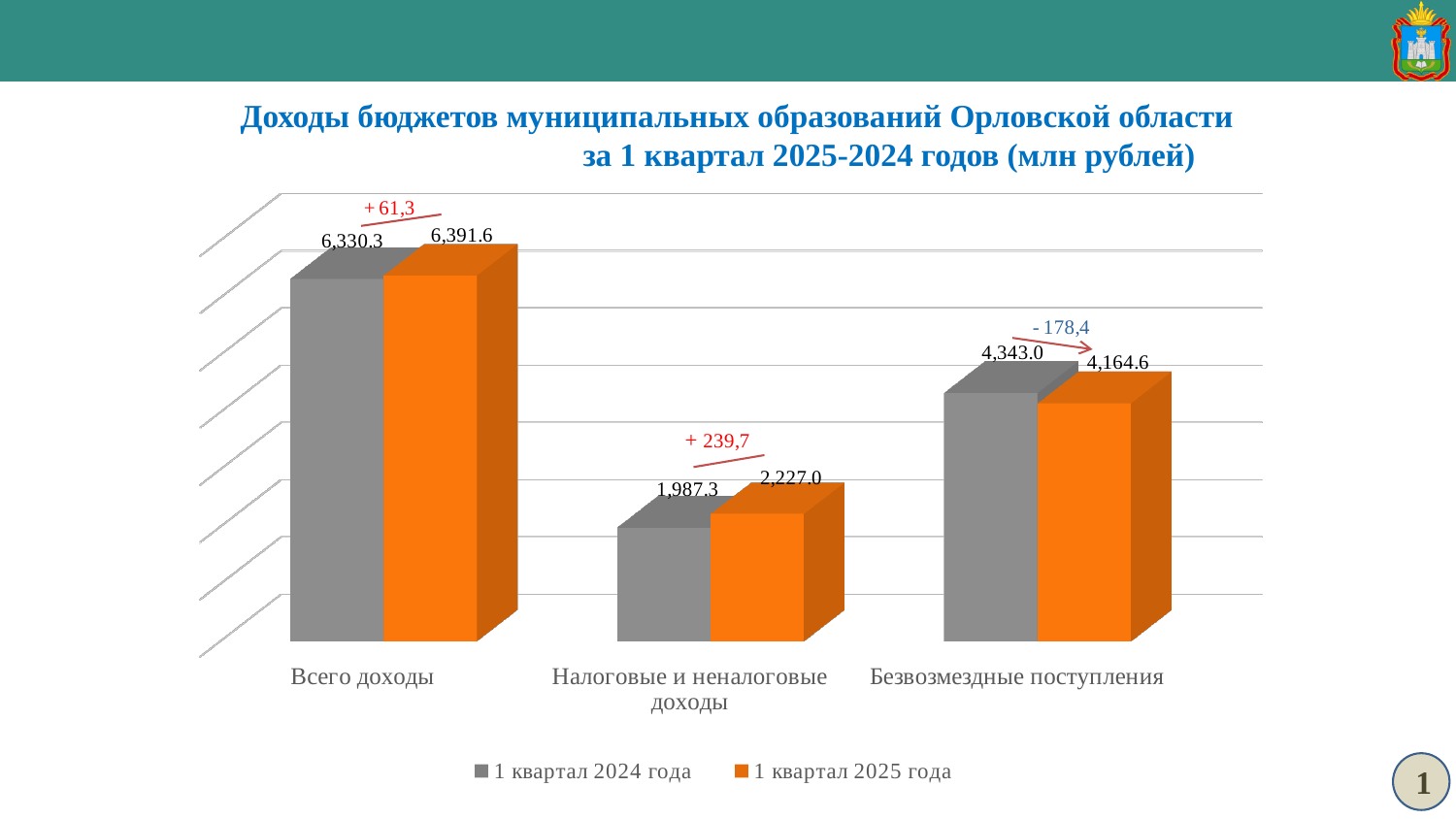
Which category has the highest value in the 1 квартал 2024 года series? Всего доходы How many series does the legend list? 2 For Безвозмездные поступления, which series has the larger value: 1 квартал 2024 года or 1 квартал 2025 года? 1 квартал 2024 года How many categories are shown on the x axis? 3 What is the difference between the 1 квартал 2025 года and 1 квартал 2024 года values for Налоговые и неналоговые доходы? 239.7 What is the value for Безвозмездные поступления in the 1 квартал 2025 года series? 4,164.6 What is the difference between the 1 квартал 2024 года and 1 квартал 2025 года values for Безвозмездные поступления? 178.4 What is the value for Всего доходы in the 1 квартал 2025 года series? 6,391.6 What kind of chart is shown on the slide? Bar chart What is the value for Налоговые и неналоговые доходы in the 1 квартал 2024 года series? 1,987.3 Which category has the lowest value in the 1 квартал 2025 года series? Налоговые и неналоговые доходы What is the value for Безвозмездные поступления in the 1 квартал 2024 года series? 4,343.0